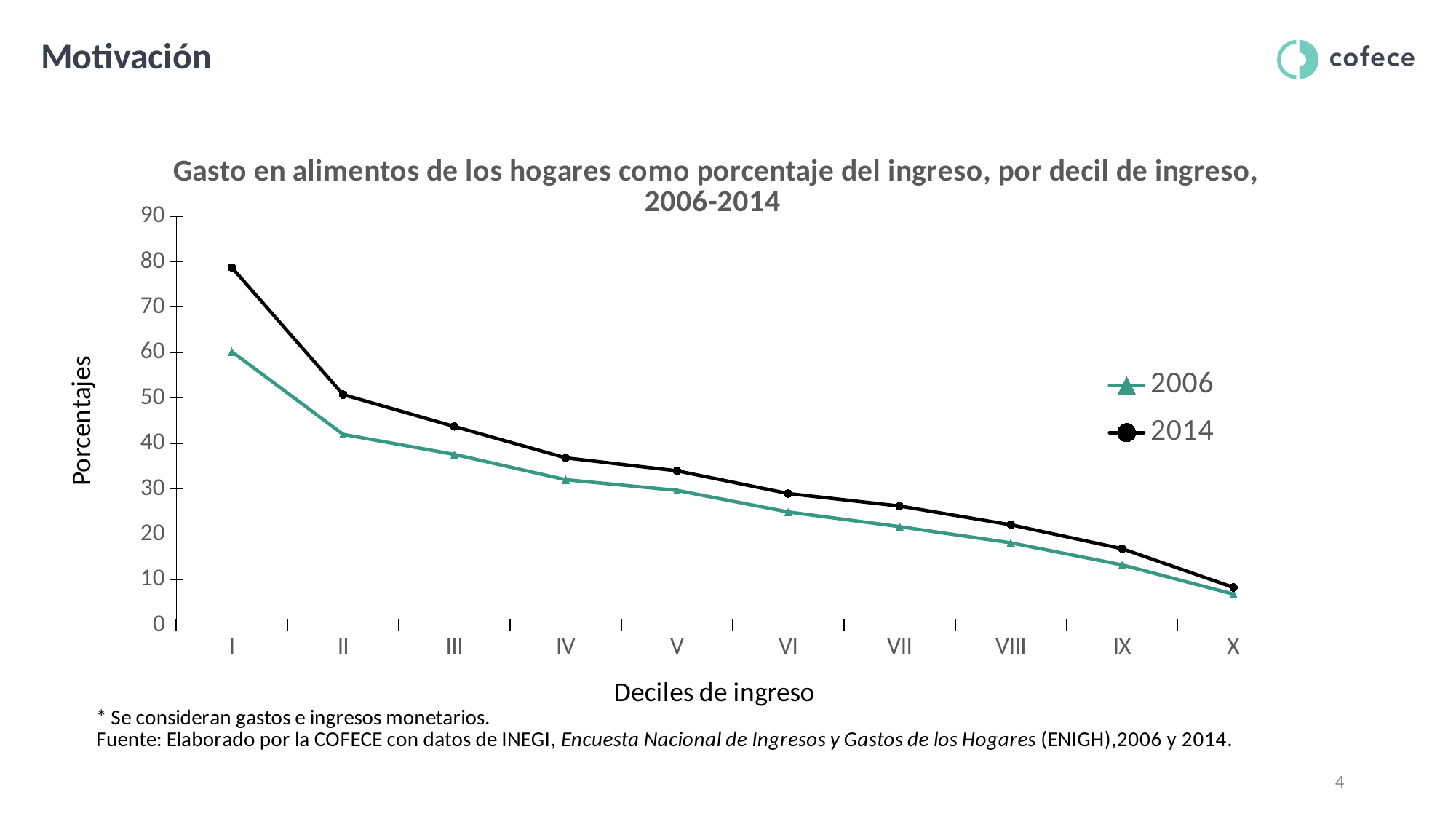
Is the 2006 value for decile I greater or less than 70? less Which decile has the highest value for the 2014 series? I Is the 2014 value for decile II greater or less than 40? greater What kind of chart is shown on the slide? line chart Is the 2006 value for decile X greater or less than 10? less How many series does the legend list? 2 Do the values rise or fall as the deciles go from I to X? fall At decile I, which series has the larger value, 2006 or 2014? 2014 Which decile has the lowest value for the 2006 series? X What is the label of the y axis? Porcentajes How many income deciles are plotted along the x axis? 10